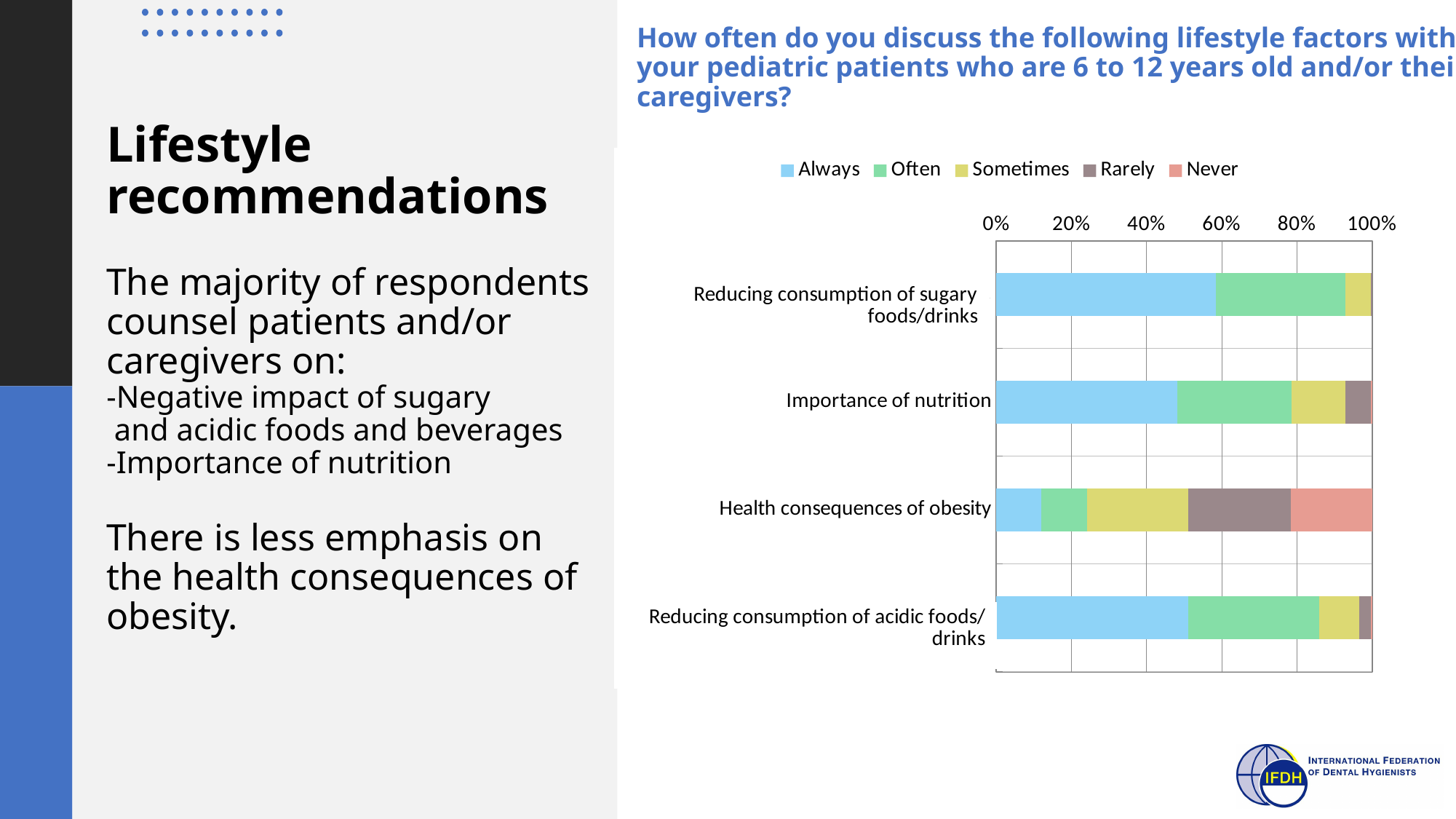
How many lifestyle factors (categories) are plotted in the chart? 4 Which lifestyle factor is the only one with a visible 'Never' segment? Health consequences of obesity Is the 'Always' share for Importance of nutrition greater or less than 40%? greater What kind of chart is shown on the slide? Stacked bar chart Which series is shown in light blue in the chart legend? Always Which lifestyle factor has the largest 'Always' share? Reducing consumption of sugary foods/drinks Is the 'Always' share for Health consequences of obesity greater or less than 20%? less Which has the larger 'Rarely' share: Health consequences of obesity or Importance of nutrition? Health consequences of obesity Is the 'Always' share for Reducing consumption of acidic foods/drinks greater or less than 40%? greater Which has the larger 'Always' share: Importance of nutrition or Health consequences of obesity? Importance of nutrition How many series does the chart legend list? 5 Which lifestyle factor has the smallest 'Always' share? Health consequences of obesity